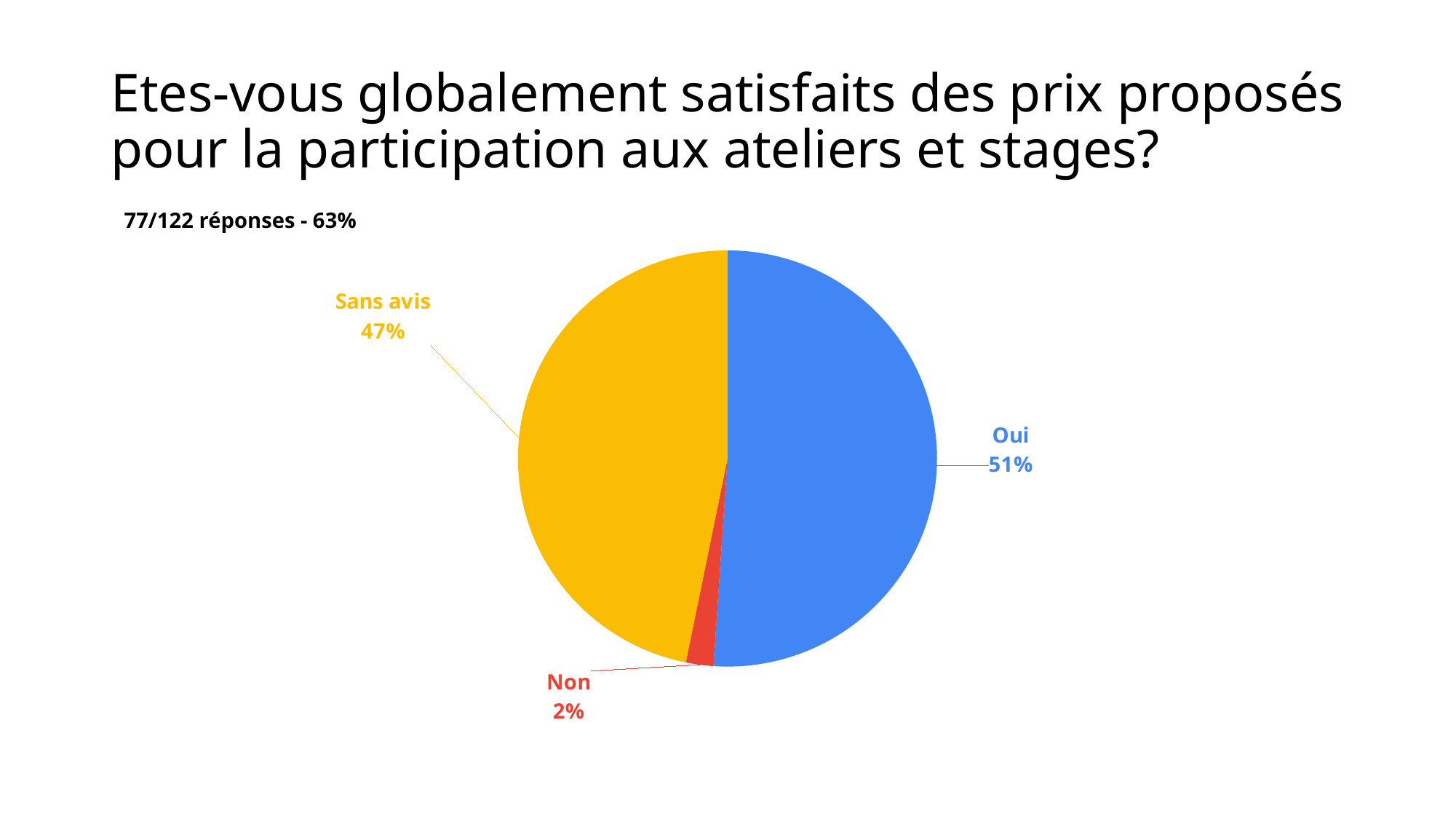
What share of the pie does "Non" represent? 2% Which category has the smallest slice of the pie? Non What colour is the "Sans avis" slice? yellow How many categories are shown in the pie chart? 3 How many responses does the slide say were received, as written under the title? 77/122 réponses - 63% What is the difference in percentage points between "Oui" and "Sans avis"? 4 What kind of chart is shown on the slide? pie chart Which category has the largest slice of the pie? Oui Which is larger, the share for "Oui" or the share for "Non"? Oui What is the difference in percentage points between "Sans avis" and "Non"? 45 What share of the pie does "Sans avis" represent? 47% What share of the pie does "Oui" represent? 51%